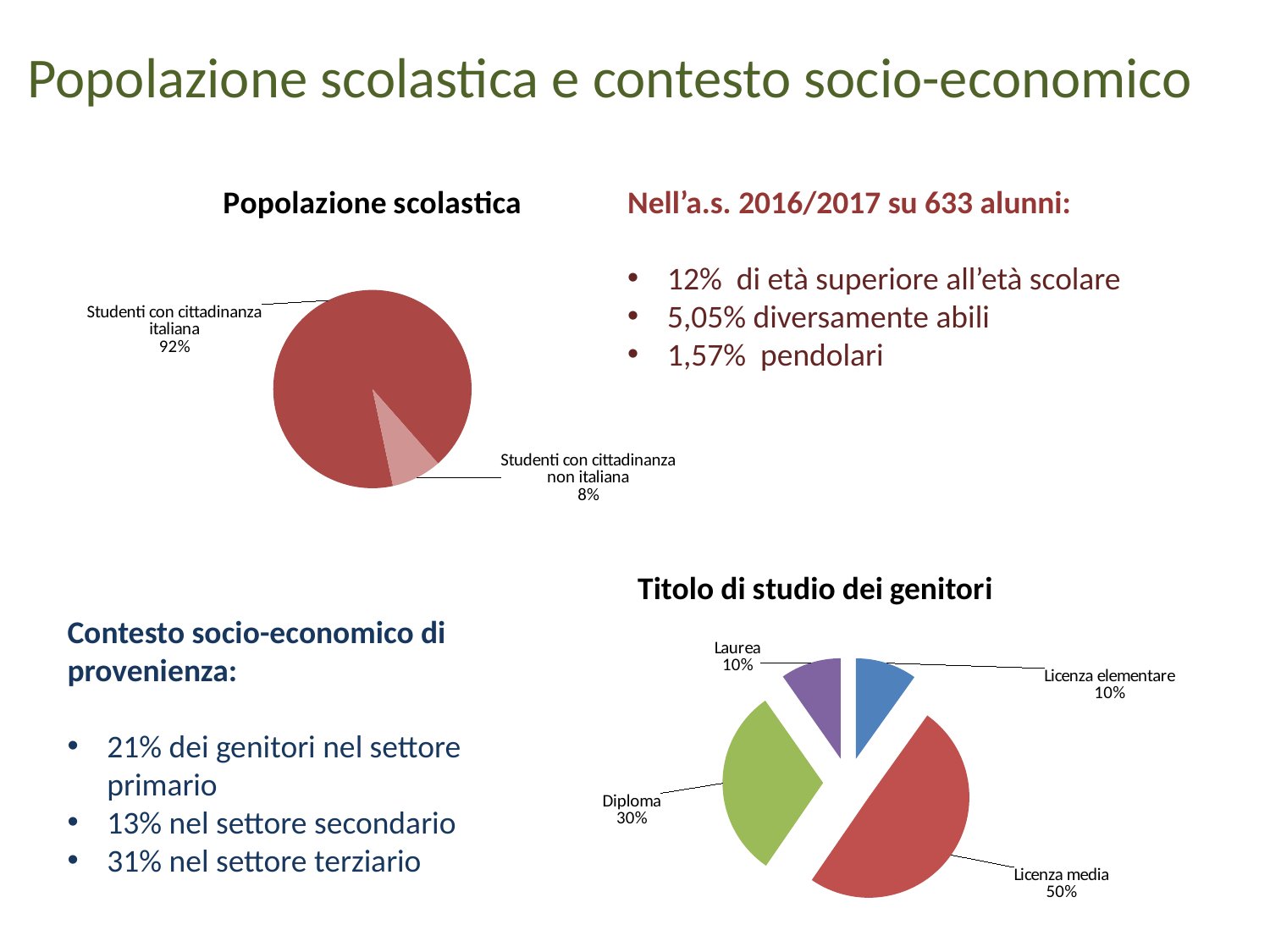
What kind of chart is 'Popolazione scolastica'? Pie chart In the 'Titolo di studio dei genitori' chart, which category has the largest share? Licenza media How many slices does the 'Popolazione scolastica' pie chart have? 2 In the 'Popolazione scolastica' chart, what share of students have non-Italian citizenship (Studenti con cittadinanza non italiana)? 8% In the 'Popolazione scolastica' chart, what is the difference in percentage points between students with Italian citizenship and students with non-Italian citizenship? 84 percentage points In the 'Titolo di studio dei genitori' chart, what share of parents have a Laurea? 10% How many categories are shown in the 'Titolo di studio dei genitori' pie chart? 4 In the 'Titolo di studio dei genitori' chart, what share of parents have a Licenza media? 50% In the 'Popolazione scolastica' chart, what share of students have Italian citizenship (Studenti con cittadinanza italiana)? 92% In the 'Titolo di studio dei genitori' chart, which is larger: Diploma or Licenza elementare? Diploma In the 'Titolo di studio dei genitori' chart, what is the difference in percentage points between Licenza media and Diploma? 20 percentage points In the 'Titolo di studio dei genitori' chart, what share of parents have a Diploma? 30%